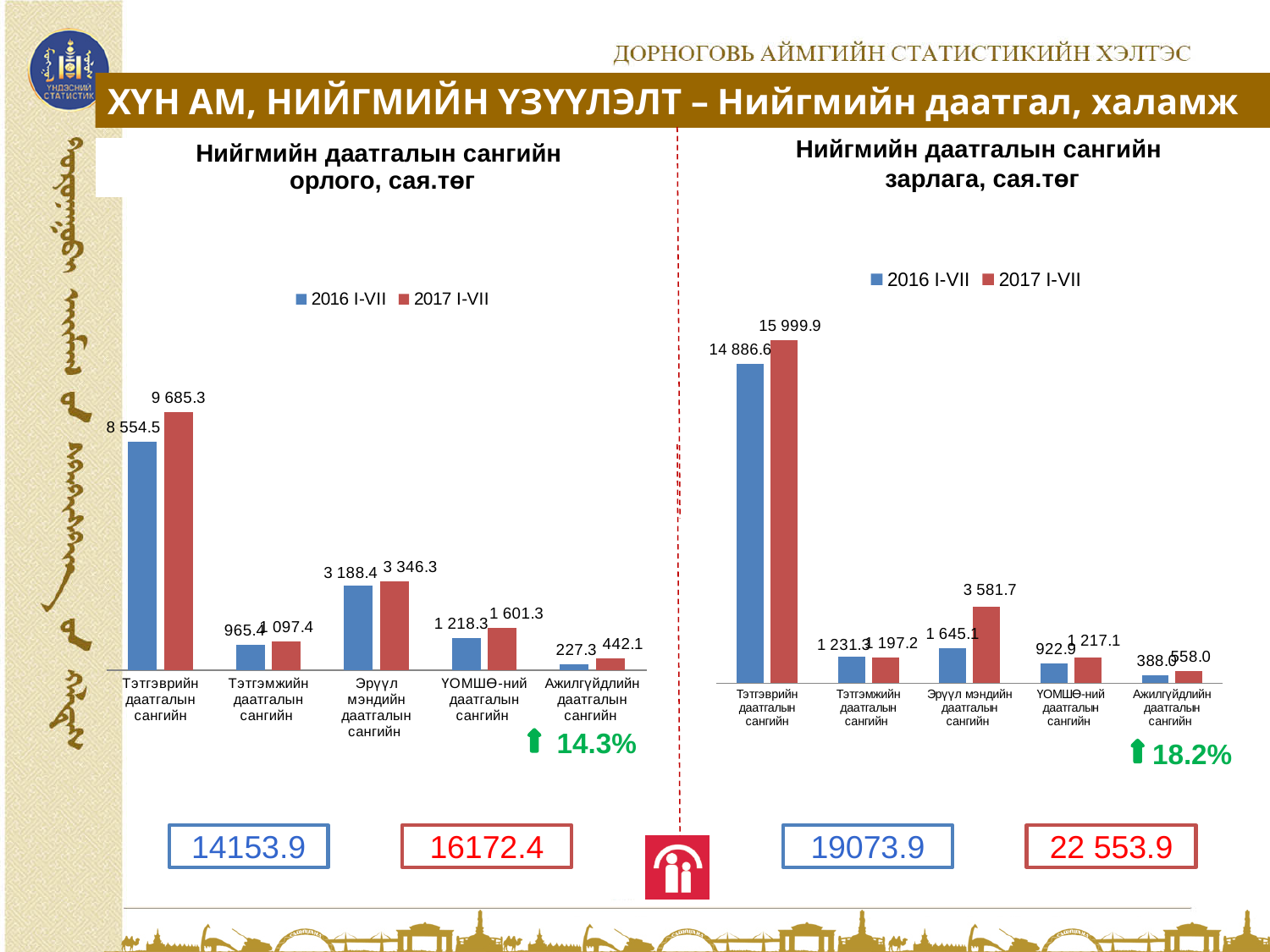
In the right chart (Нийгмийн даатгалын сангийн зарлага), which is larger for Тэтгэмжийн даатгалын сангийн: the 2016 I-VII value or the 2017 I-VII value? 2016 I-VII In the left chart (Нийгмийн даатгалын сангийн орлого), what is the 2017 I-VII value for Тэтгэврийн даатгалын сангийн? 9 685.3 In the right chart (Нийгмийн даатгалын сангийн зарлага), what is the 2017 I-VII value for Эрүүл мэндийн даатгалын сангийн? 3 581.7 In the right chart (Нийгмийн даатгалын сангийн зарлага), what is the 2016 I-VII value for Тэтгэврийн даатгалын сангийн? 14 886.6 How many series does the legend of the right chart (Нийгмийн даатгалын сангийн зарлага) list? 2 In the left chart (Нийгмийн даатгалын сангийн орлого), what is the difference between the 2017 I-VII and 2016 I-VII values for Тэтгэврийн даатгалын сангийн? 1 130.8 In the left chart (Нийгмийн даатгалын сангийн орлого), which category has the highest 2017 I-VII value? Тэтгэврийн даатгалын сангийн In the left chart (Нийгмийн даатгалын сангийн орлого), what is the 2016 I-VII value for Эрүүл мэндийн даатгалын сангийн? 3 188.4 In the left chart (Нийгмийн даатгалын сангийн орлого), which category has the lowest 2016 I-VII value? Ажилгүйдлийн даатгалын сангийн What type of chart is the right chart (Нийгмийн даатгалын сангийн зарлага)? Bar chart In the right chart (Нийгмийн даатгалын сангийн зарлага), what is the difference between the 2017 I-VII and 2016 I-VII values for Эрүүл мэндийн даатгалын сангийн? 1 936.6 How many categories are shown on the x axis of the left chart (Нийгмийн даатгалын сангийн орлого)? 5